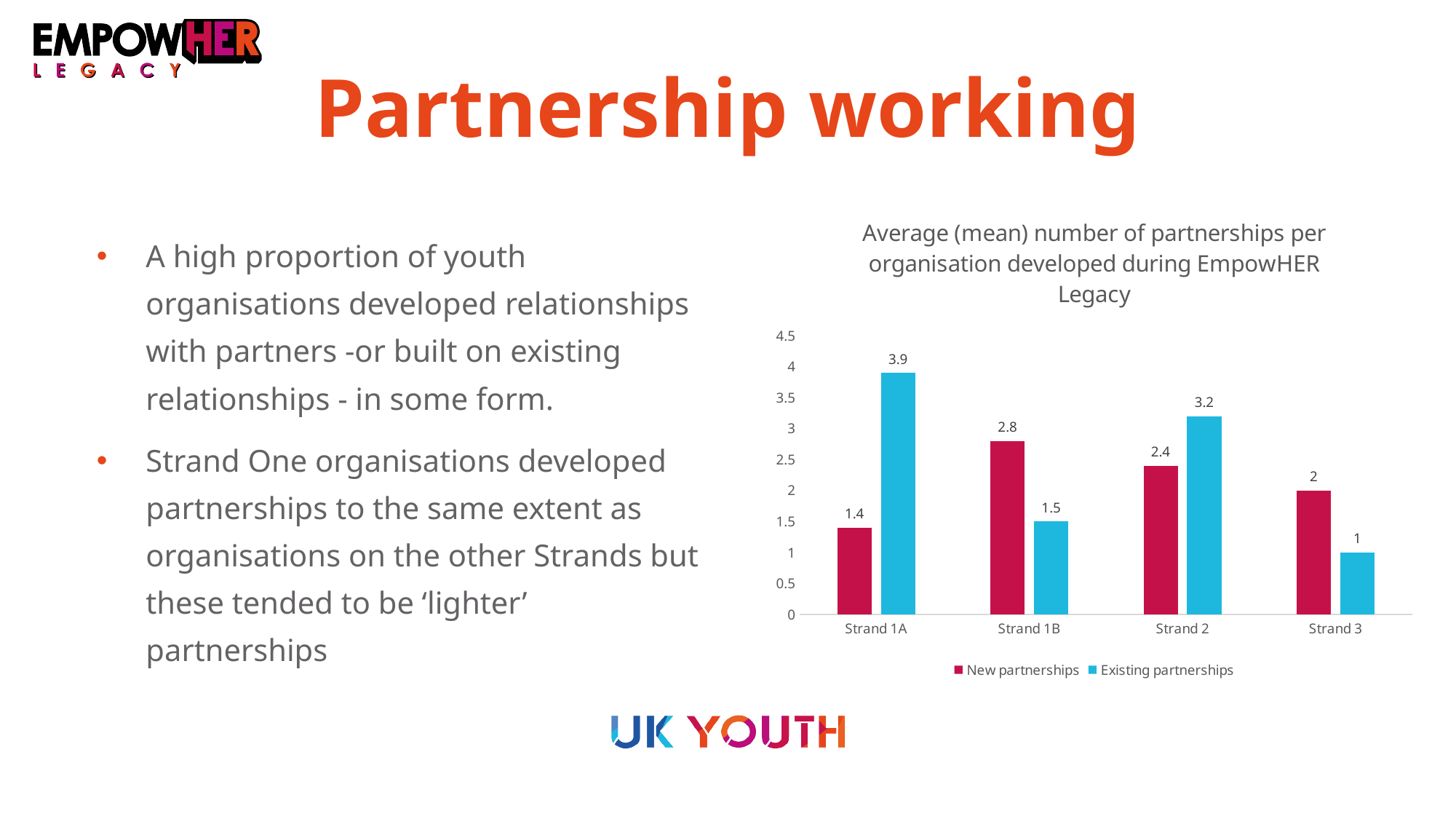
How many strands are shown on the x axis? 4 Which is larger for Strand 1B: New partnerships or Existing partnerships? New partnerships Which strand has the lowest value for New partnerships? Strand 1A What is the difference between Existing partnerships and New partnerships for Strand 1A? 2.5 What is the value for Existing partnerships for Strand 3? 1 Which strand has the highest value for Existing partnerships? Strand 1A What is the value for Existing partnerships for Strand 2? 3.2 What kind of chart is shown on the slide? Bar chart What is the value for New partnerships for Strand 1A? 1.4 How many series does the legend list? 2 Is the value for Existing partnerships for Strand 1A greater or less than 3.5? greater What colour are the bars for Existing partnerships? Blue